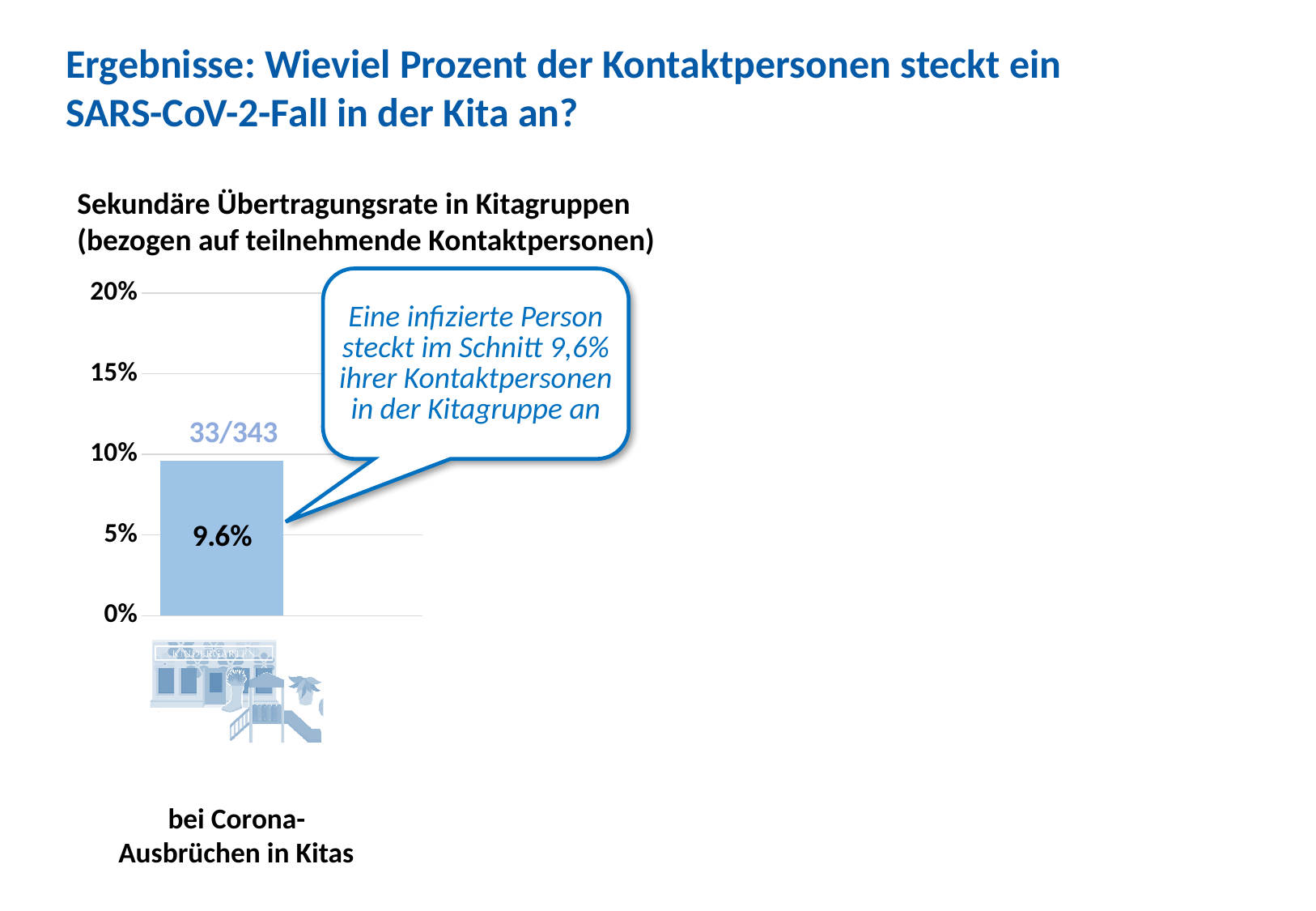
How many bars does the chart contain? 1 What kind of chart is shown on the slide? bar chart Is the value for "bei Corona-Ausbrüchen in Kitas" greater or less than 10%? less Is the value for "bei Corona-Ausbrüchen in Kitas" greater or less than 5%? greater What is the secondary transmission rate shown for "bei Corona-Ausbrüchen in Kitas"? 9.6% What is the title of the chart? Sekundäre Übertragungsrate in Kitagruppen (bezogen auf teilnehmende Kontaktpersonen) What is the highest value shown on the vertical axis? 20% What fraction is printed above the bar for "bei Corona-Ausbrüchen in Kitas"? 33/343